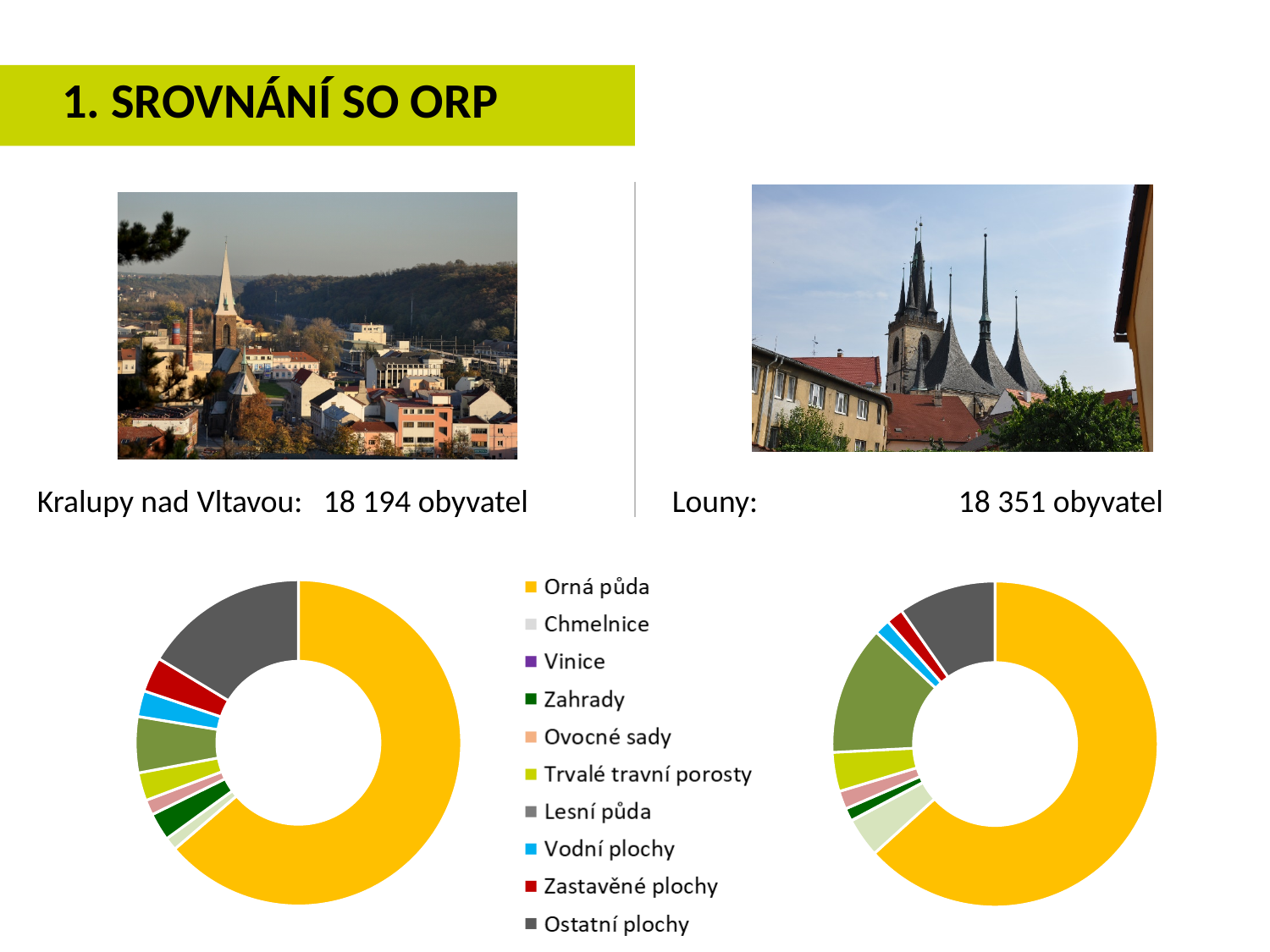
In the right chart (Louny), which category has the largest share? Orná půda What colour represents Vodní plochy in the legend? blue In the right chart (Louny), is the share of Orná půda greater or less than half of the whole? greater What colour represents Orná půda in the legend? yellow What kind of chart is used for Kralupy nad Vltavou on the left of the slide? doughnut (pie) chart How many land-use categories does the shared legend list? 10 In the left chart (Kralupy nad Vltavou), is the share of Orná půda greater or less than half of the whole? greater In the left chart (Kralupy nad Vltavou), which category has the largest share? Orná půda In the right chart (Louny), which is larger: Trvalé travní porosty or Zastavěné plochy? Trvalé travní porosty